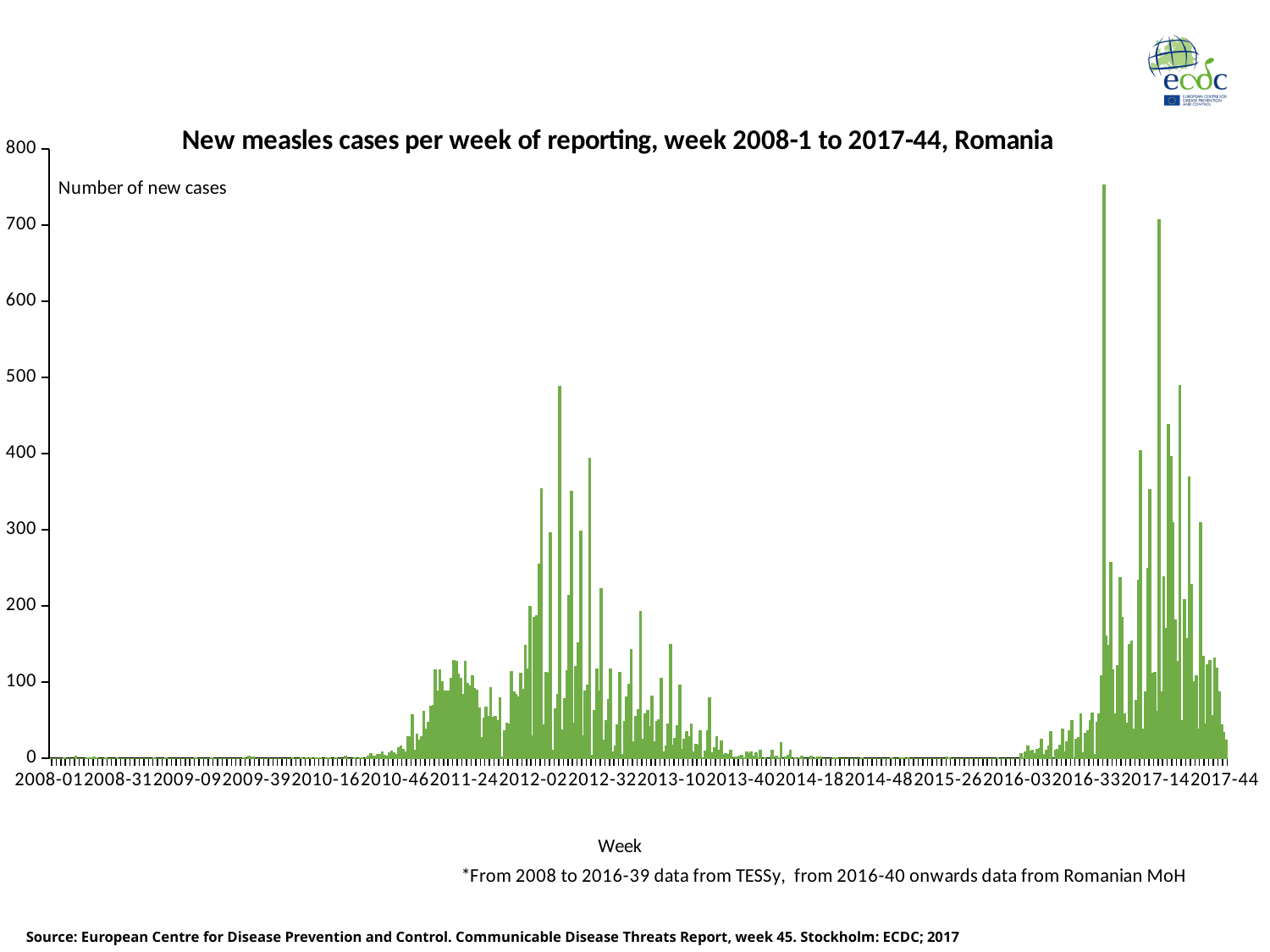
Is the highest weekly peak in the 2012 outbreak greater or less than 400 new cases? greater Are the weekly case counts between 2014-18 and 2015-26 greater or less than 100? less What kind of chart is shown on the slide? Bar chart Is the tallest bar in the chart greater or less than 700 new cases? greater Which outbreak period reached a higher weekly peak: the one around 2012 or the one around 2017? The one around 2017 What is the last week label shown on the horizontal axis? 2017-44 What is the highest value shown on the vertical axis? 800 What does the vertical axis of the chart measure, according to its label? Number of new cases Do the weekly case counts rise or fall from week 2016-03 toward the 2017 peak? rise Do the weekly case counts rise or fall from the 2012 peak toward 2014-18? fall